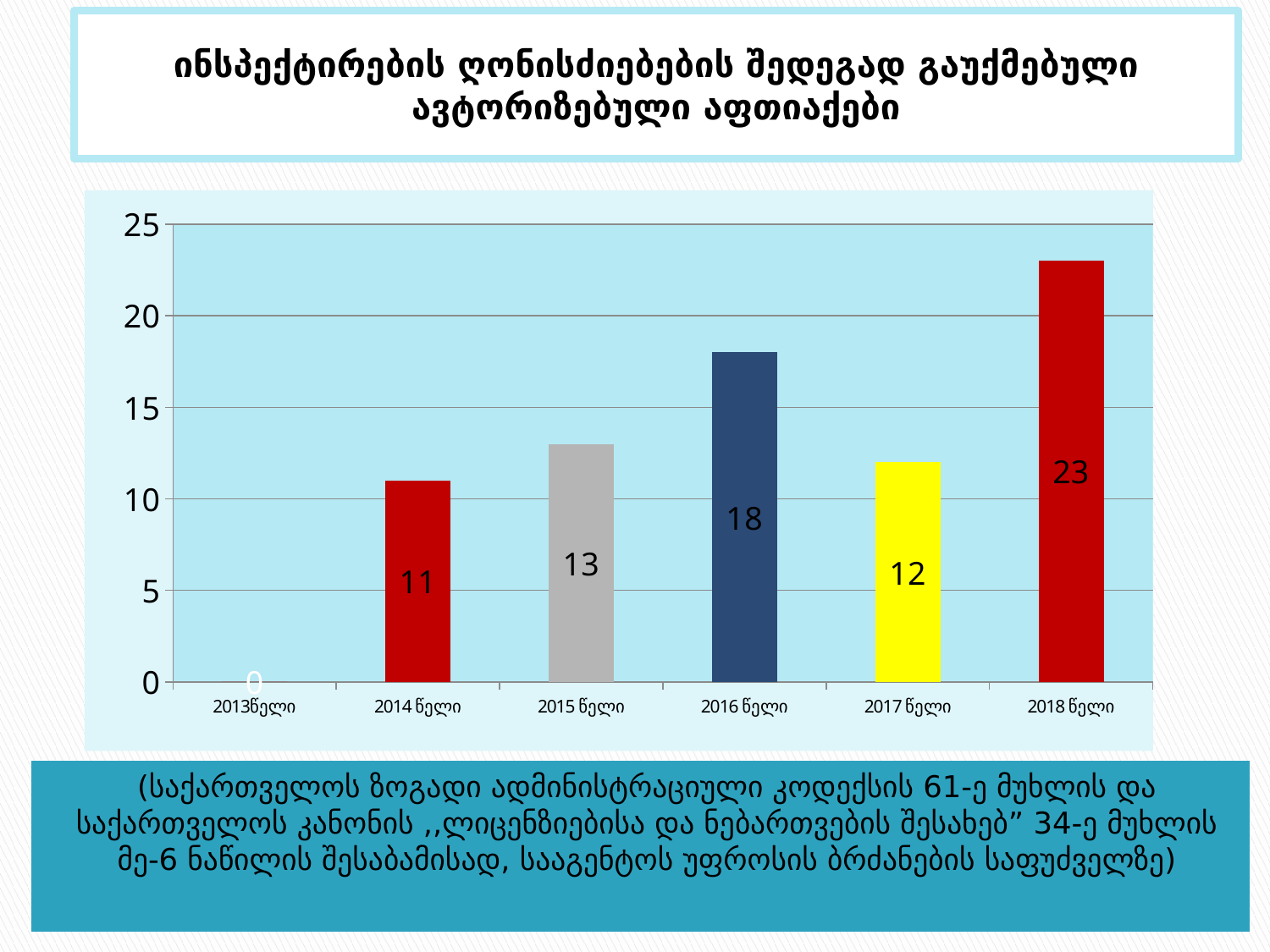
Which is larger, the value for 2015 წელი or the value for 2017 წელი? 2015 წელი What colour is the bar for 2016 წელი? dark blue Is the value for 2018 წელი greater or less than 20? greater Which year has the lowest value? 2013წელი What is the value for 2014 წელი? 11 What is the difference between the values for 2018 წელი and 2016 წელი? 5 What is the difference between the values for 2015 წელი and 2014 წელი? 2 What is the value for 2016 წელი? 18 Which year has the highest value? 2018 წელი What kind of chart is shown on the slide? bar chart What is the value for 2017 წელი? 12 How many years are shown on the x axis? 6